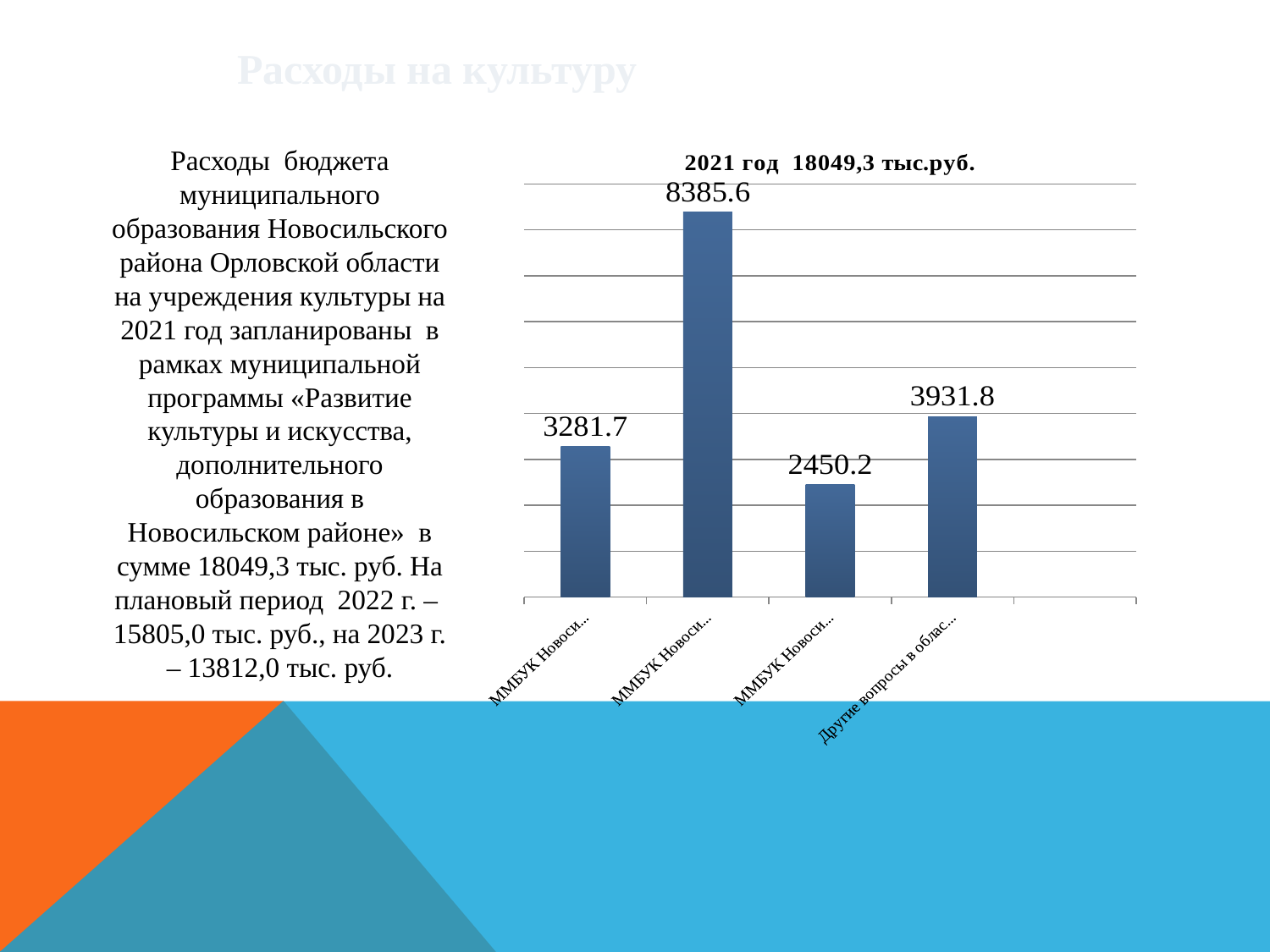
What is the value of the third bar from the left? 2450.2 What type of chart is shown on the slide? Bar chart What is the difference between the rightmost bar (3931.8) and the leftmost bar (3281.7)? 650.1 What is the difference between the highest bar (8385.6) and the lowest bar (2450.2)? 5935.4 How many bars are plotted in the chart? 4 What is the value of the fourth (rightmost) bar, labelled 'Другие вопросы в облас...'? 3931.8 Which bar has the lowest value? The third bar from the left (2450.2) What is the value of the first (leftmost) bar? 3281.7 What is the value of the second bar from the left? 8385.6 What is the title of the chart? 2021 год 18049,3 тыс.руб. Which is larger: the value of the leftmost bar or the value of the rightmost bar? The rightmost bar (3931.8) Which bar has the highest value? The second bar from the left (8385.6)